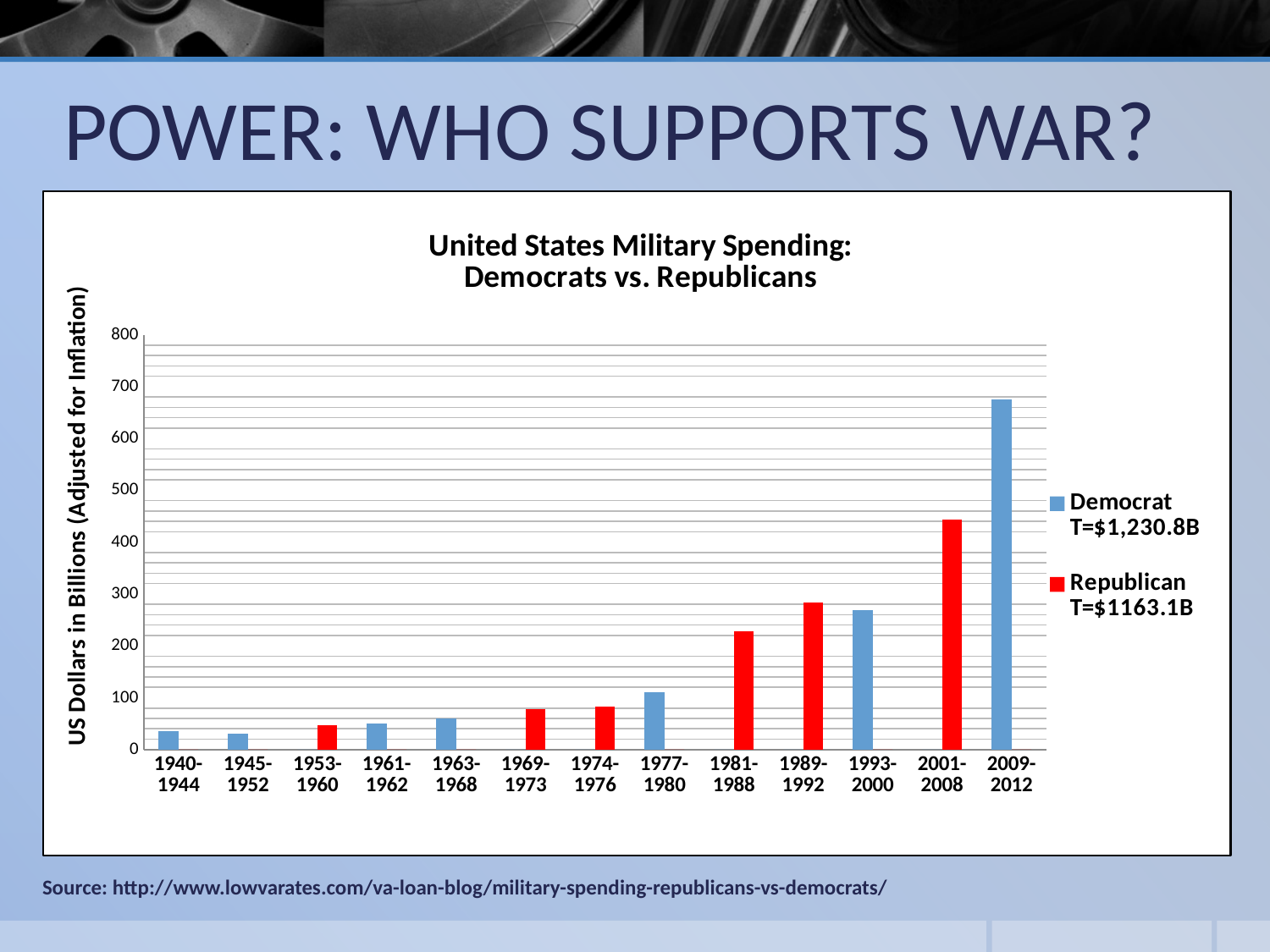
Which is larger, the value for 2001-2008 or the value for 1993-2000? 2001-2008 Is the value for 2009-2012 greater or less than 600? greater Is the value for 2001-2008 greater or less than 400? greater Is the value for 1981-1988 greater or less than 200? greater How many series does the chart's legend list? 2 How many time periods are shown along the x axis of the chart? 13 What is the label on the y axis of the chart? US Dollars in Billions (Adjusted for Inflation) What kind of chart is shown on the slide? Bar chart What total does the legend give for the Democrat series? T=$1,230.8B Do the values generally rise or fall from left to right along the x axis? Rise Which time period has the highest military spending in the chart? 2009-2012